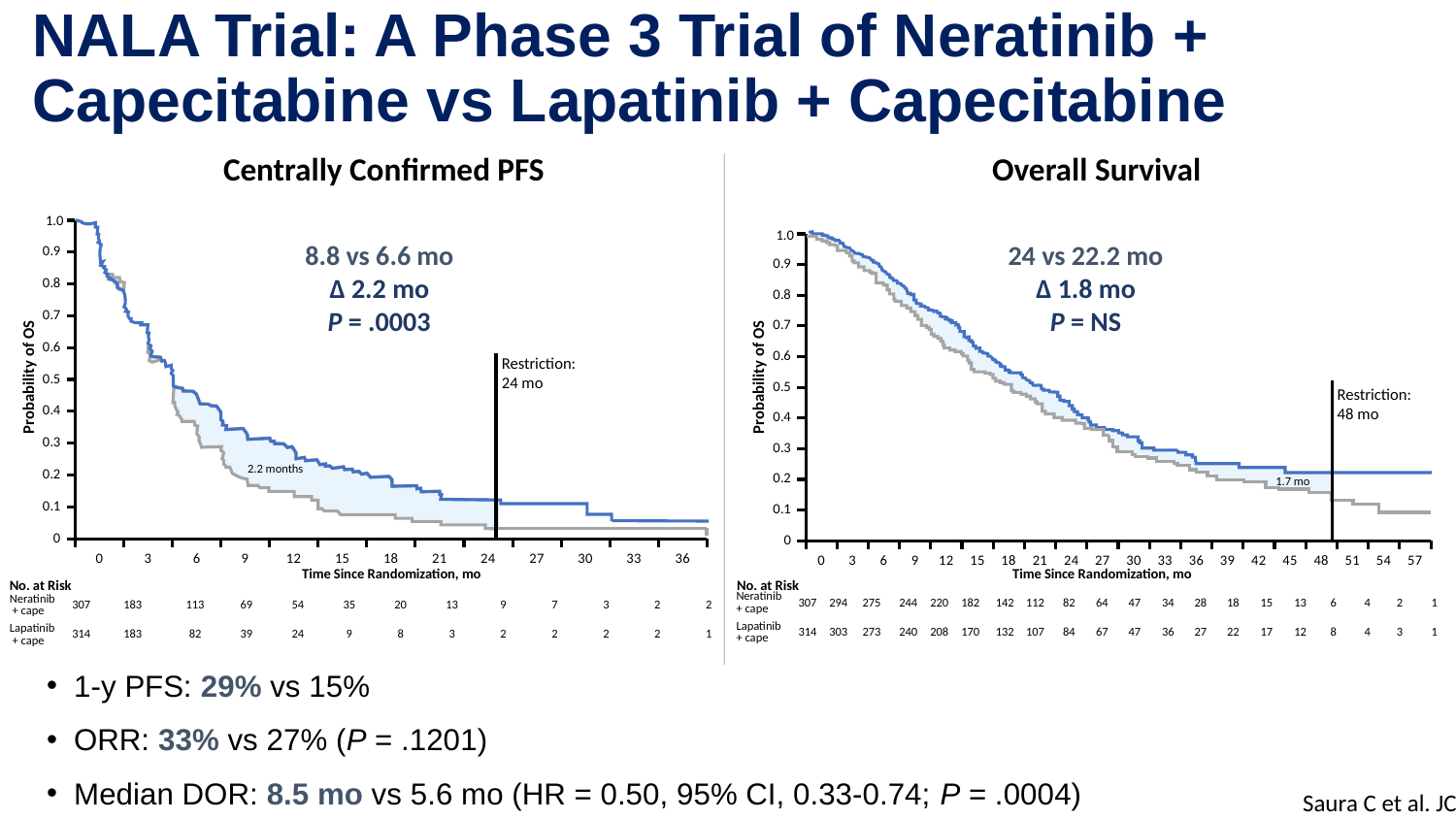
In the Overall Survival chart, how many patients were at risk in the lapatinib + cape arm at 0 months? 314 In the Centrally Confirmed PFS chart, what is the median PFS for neratinib + capecitabine versus lapatinib + capecitabine? 8.8 vs 6.6 mo In the Overall Survival chart, do the survival curves rise or fall as time since randomization increases? Fall In the Centrally Confirmed PFS chart, is the probability for the neratinib + cape curve at 12 months greater or less than 0.5? less In the Centrally Confirmed PFS chart, what is the difference in the number at risk at 6 months between the neratinib + cape arm (113) and the lapatinib + cape arm (82)? 31 How many treatment arms are plotted in the Overall Survival chart? 2 What kind of chart is the Centrally Confirmed PFS chart? Line chart (Kaplan-Meier survival curve) In the Overall Survival chart, what is the restriction time shown by the vertical line? 48 mo In the Centrally Confirmed PFS chart, what P value is shown? P = .0003 In the Overall Survival chart, what is the difference (Δ) in median overall survival between the two arms? Δ 1.8 mo In the Overall Survival chart, which arm had more patients at risk at 24 months: neratinib + cape or lapatinib + cape? Lapatinib + cape In the Centrally Confirmed PFS chart, how many patients were at risk in the neratinib + cape arm at 6 months? 113